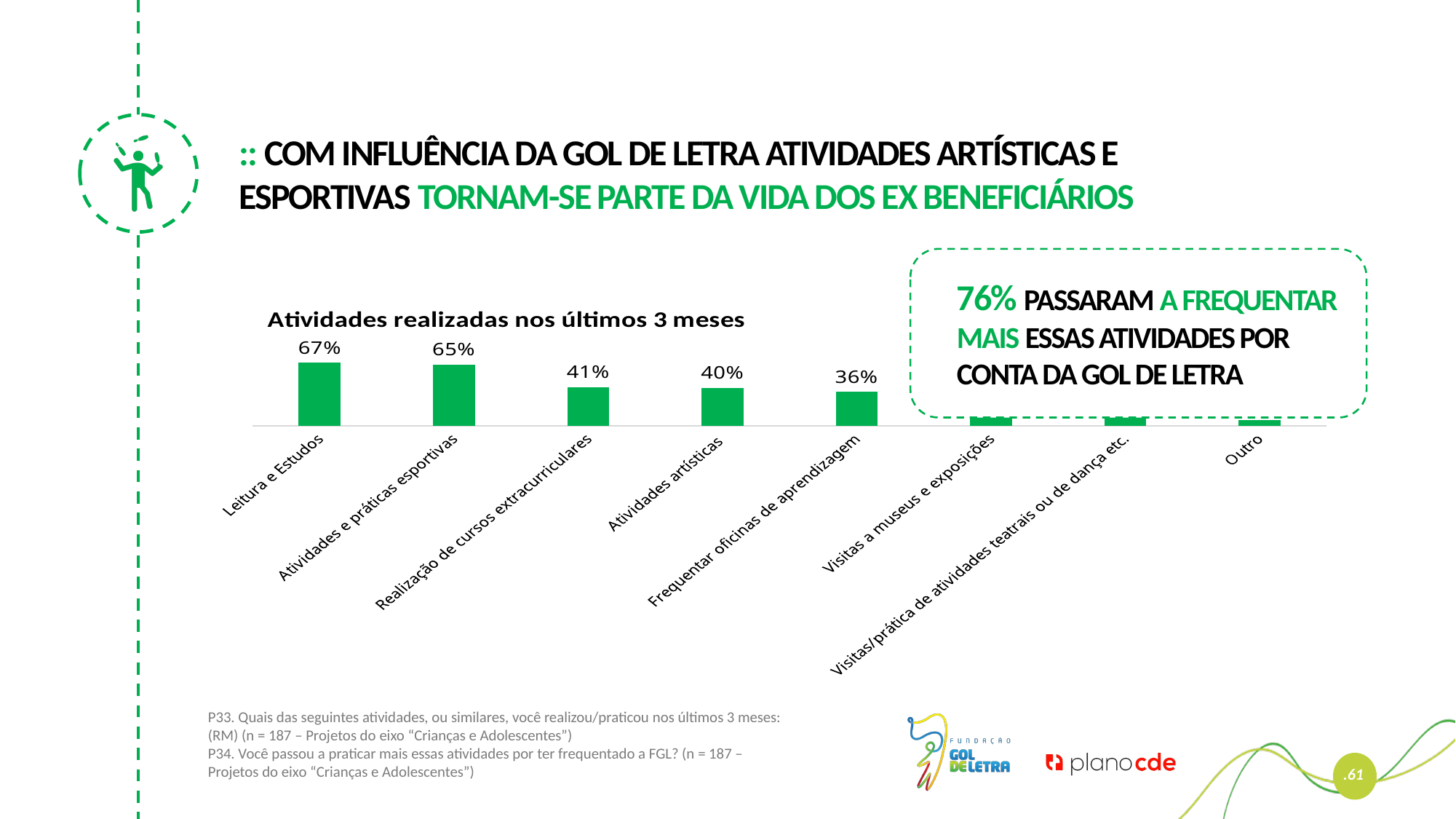
What kind of chart is shown on the slide? Bar chart Which activity has the highest value in the chart? Leitura e Estudos What is the value for Realização de cursos extracurriculares? 41% What is the difference in percentage points between Leitura e Estudos and Frequentar oficinas de aprendizagem? 31 percentage points What is the value for Leitura e Estudos in the chart 'Atividades realizadas nos últimos 3 meses'? 67% What is the title of the chart? Atividades realizadas nos últimos 3 meses What is the value for Frequentar oficinas de aprendizagem? 36% What is the difference in percentage points between Leitura e Estudos and Atividades e práticas esportivas? 2 percentage points What is the value for Atividades artísticas? 40% What is the value for Atividades e práticas esportivas? 65% Which is larger, the value for Realização de cursos extracurriculares or the value for Frequentar oficinas de aprendizagem? Realização de cursos extracurriculares How many categories are shown on the x axis of the chart? 8